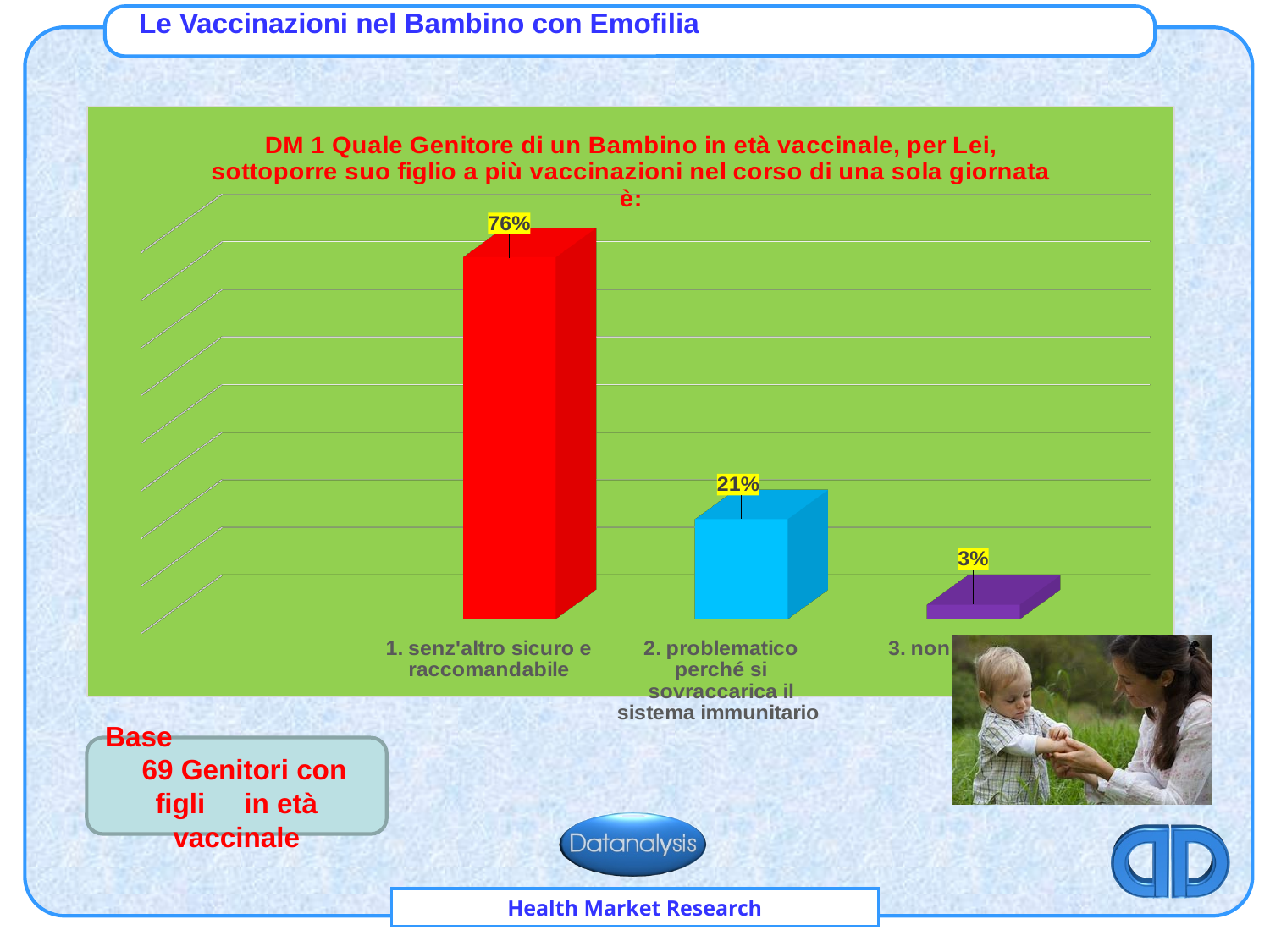
Which bar has the lowest value? The third (purple) bar, 3% Which is larger: the value for "1. senz'altro sicuro e raccomandabile" or for "2. problematico perché si sovraccarica il sistema immunitario"? 1. senz'altro sicuro e raccomandabile How many bars are plotted in the chart? 3 Which category has the highest value? 1. senz'altro sicuro e raccomandabile What colour is the bar for "1. senz'altro sicuro e raccomandabile"? Red What is the difference between the values for "1. senz'altro sicuro e raccomandabile" and "2. problematico perché si sovraccarica il sistema immunitario"? 55% Do the values rise or fall from left to right across the bars? Fall What is the value shown for "2. problematico perché si sovraccarica il sistema immunitario"? 21% What kind of chart is shown on the slide? Bar chart What is the difference between the second bar (21%) and the third bar (3%)? 18% What value is printed above the third (purple) bar? 3% What percentage of respondents chose "1. senz'altro sicuro e raccomandabile"? 76%